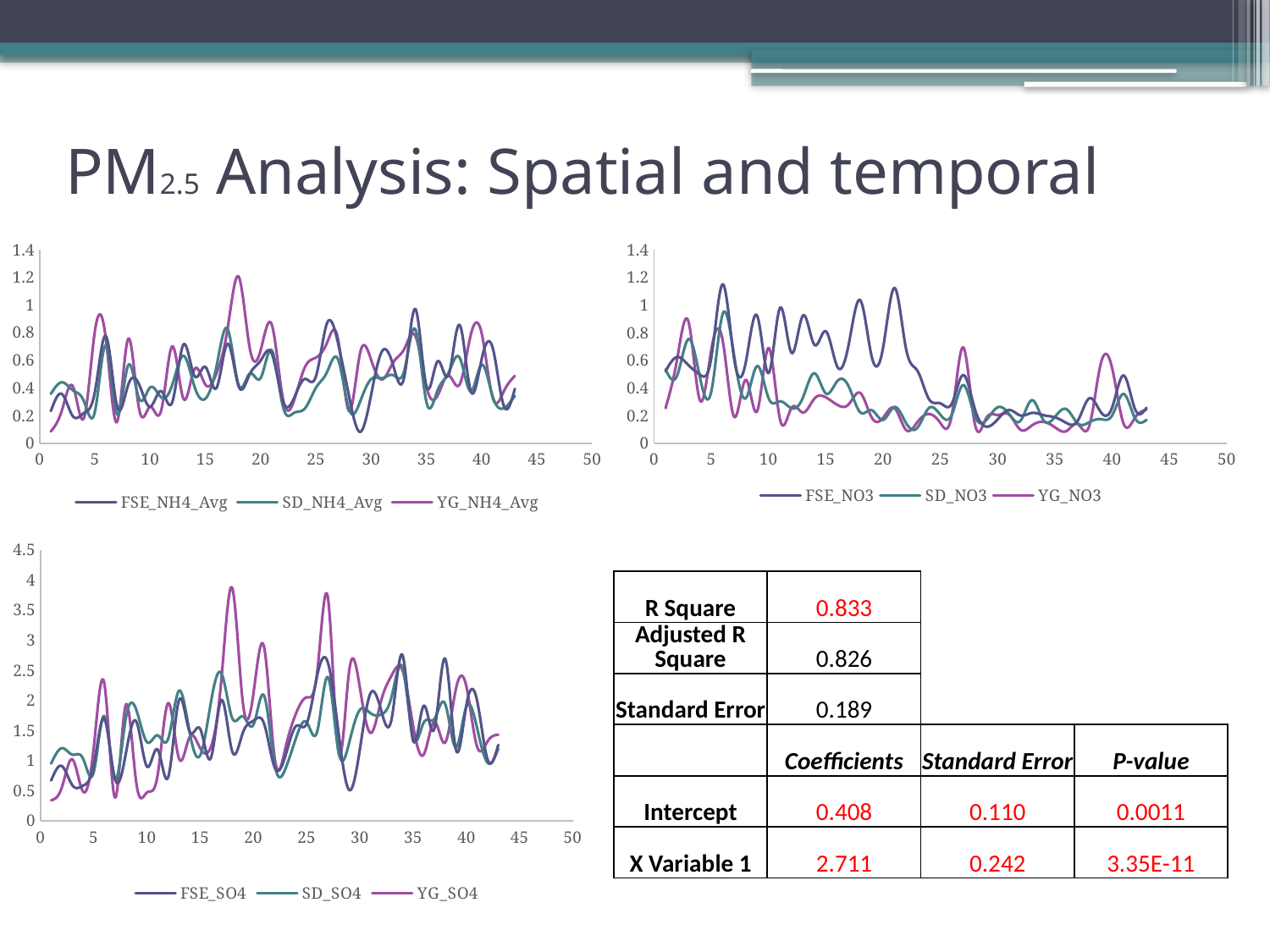
In the top-right NO3 chart, which series reaches the highest peak value? FSE_NO3 In the top-right NO3 chart, is the highest peak of YG_NO3 greater or less than 1? less In the bottom-left SO4 chart, is the highest peak of YG_SO4 greater or less than 3.5? greater In the top-left NH4 chart, is the highest peak of YG_NH4_Avg greater or less than 1? greater What kind of chart is the top-left chart with the NH4 series? Line chart What are the three legend entries of the bottom-left chart? FSE_SO4, SD_SO4, YG_SO4 How many series does the legend of the top-right NO3 chart list? 3 How many series does the legend of the bottom-left SO4 chart list? 3 How many series does the legend of the top-left NH4 chart list? 3 In the bottom-left SO4 chart, which series reaches the highest peak value? YG_SO4